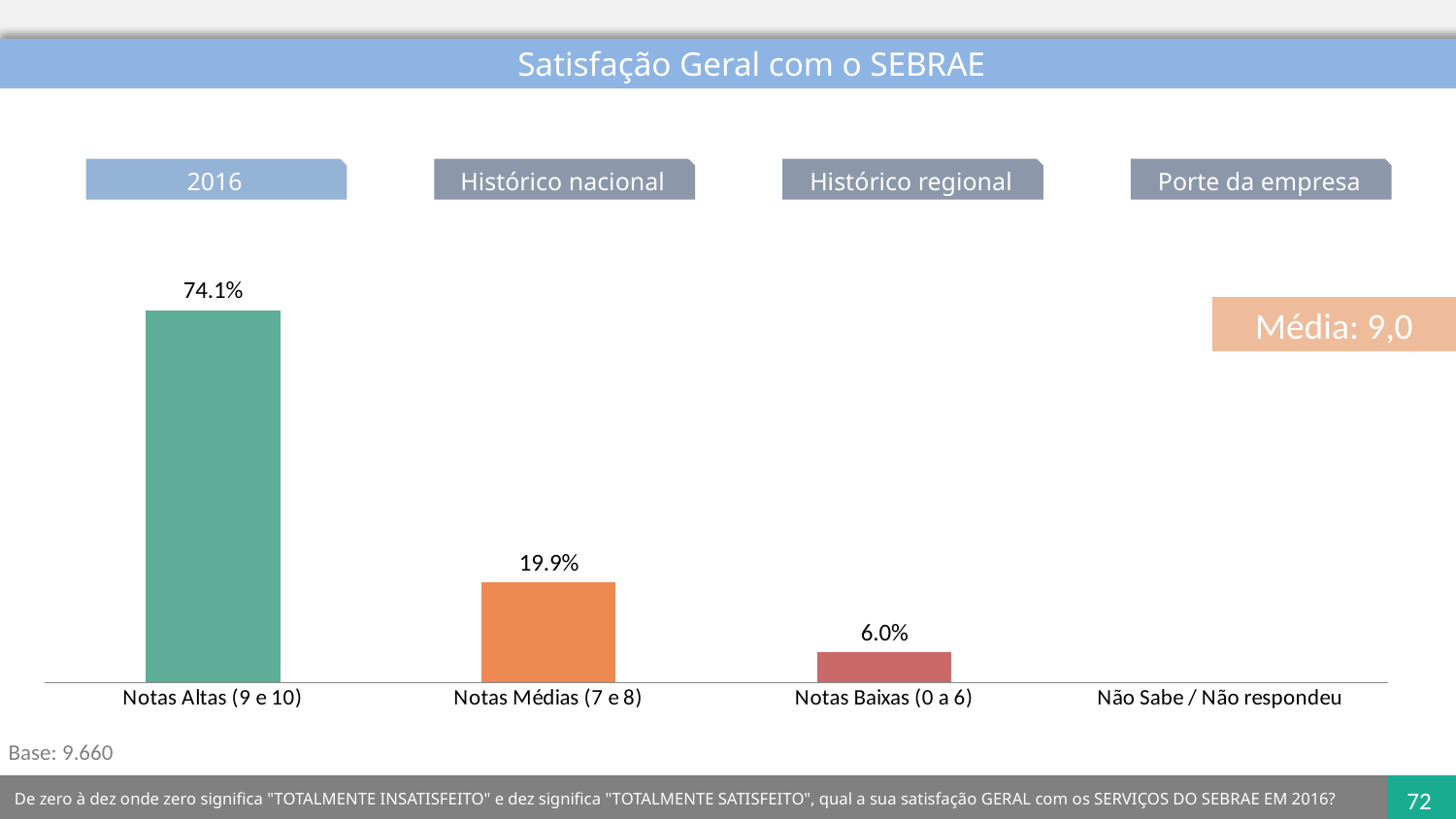
Which category has the highest value? Notas Altas (9 e 10) What is the value for Notas Baixas (0 a 6)? 6.0% Which is larger, the value for Notas Médias (7 e 8) or the value for Notas Baixas (0 a 6)? Notas Médias (7 e 8) What is the value for Notas Altas (9 e 10)? 74.1% What is the difference between the values for Notas Altas (9 e 10) and Notas Médias (7 e 8)? 54.2% Which of the categories with a labelled bar has the lowest value? Notas Baixas (0 a 6) What is the title of the chart on the slide? Satisfação Geral com o SEBRAE How many categories are shown on the x axis of the chart? 4 Do the bar values rise or fall from left to right along the x axis? Fall What kind of chart is shown on the slide? Bar chart What is the difference between the values for Notas Médias (7 e 8) and Notas Baixas (0 a 6)? 13.9% What is the value for Notas Médias (7 e 8)? 19.9%